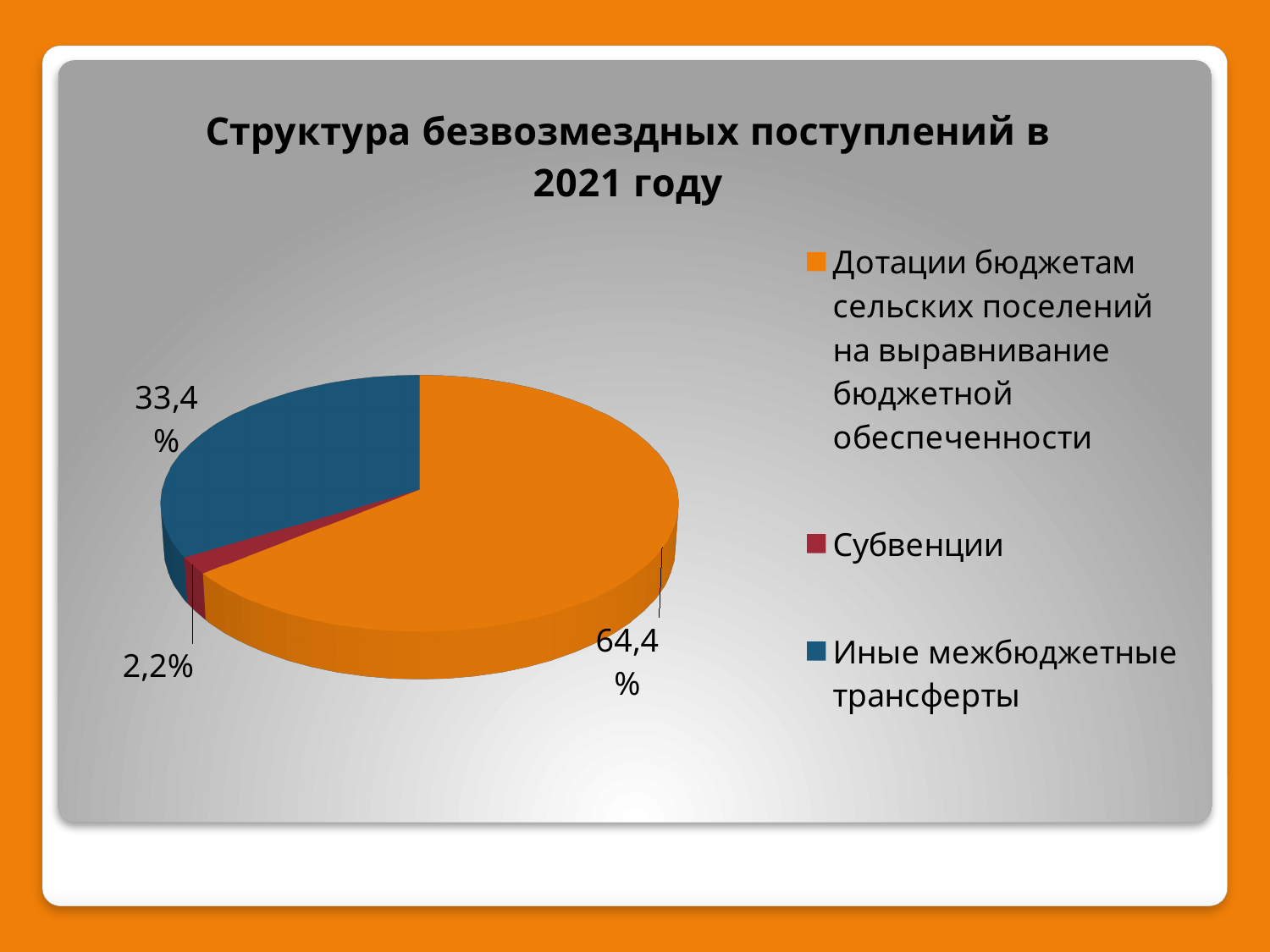
Which is larger: the slice for Иные межбюджетные трансферты or the slice for Субвенции? Иные межбюджетные трансферты What kind of chart is shown on the slide? pie chart What share of the pie is labelled for Дотации бюджетам сельских поселений на выравнивание бюджетной обеспеченности? 64,4% What colour is the slice for Субвенции? red What is the difference in percentage points between the Дотации slice (64,4%) and the Иные межбюджетные трансферты slice (33,4%)? 31,0 What share of the pie is labelled for Иные межбюджетные трансферты? 33,4% How many slices does the pie chart have? 3 Which category has the largest slice of the pie? Дотации бюджетам сельских поселений на выравнивание бюджетной обеспеченности What is the title of the chart? Структура безвозмездных поступлений в 2021 году Which category has the smallest slice of the pie? Субвенции What share of the pie is labelled for Субвенции? 2,2% How many entries does the legend list? 3